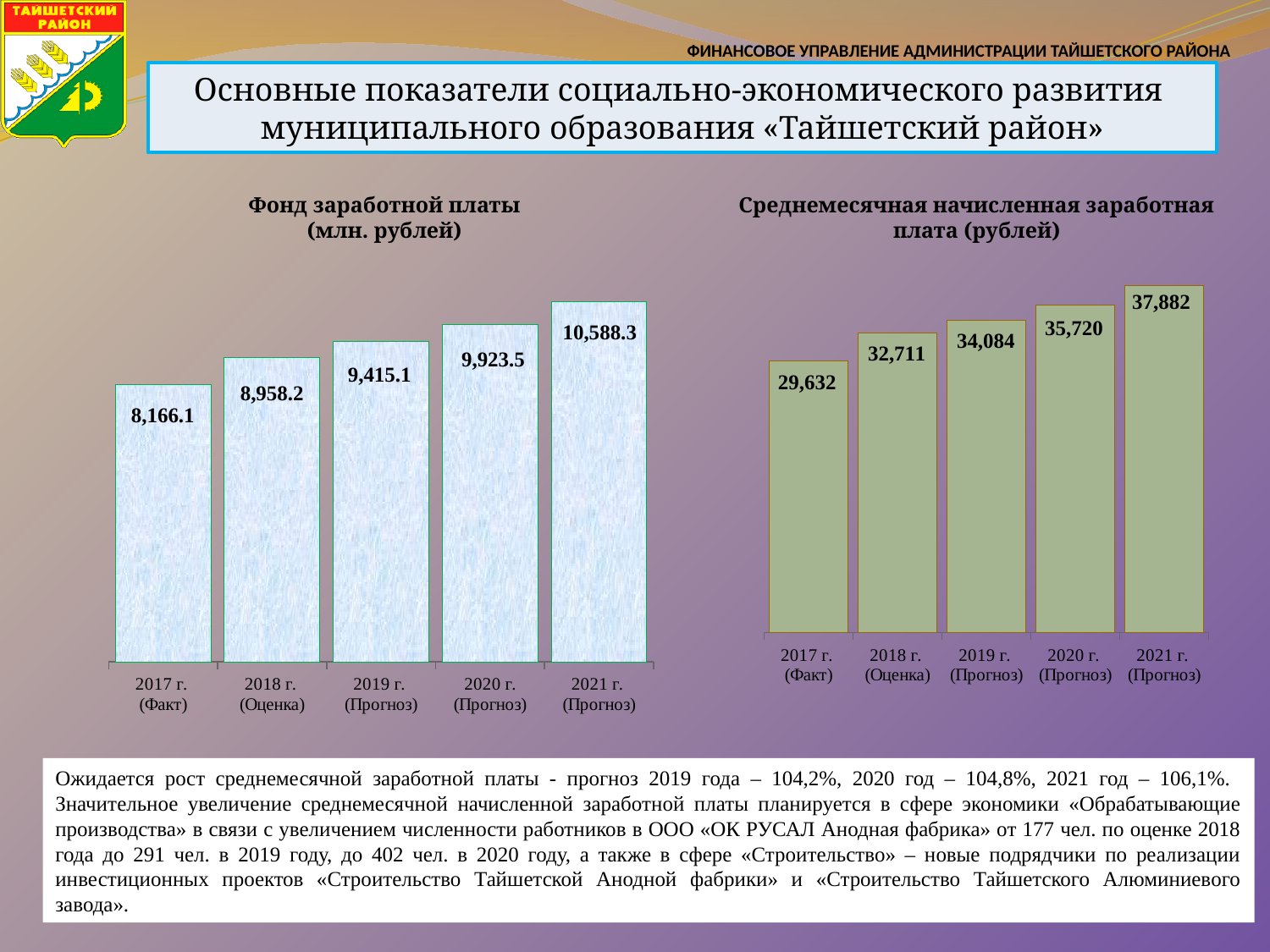
How many bars are in the chart titled «Среднемесячная начисленная заработная плата (рублей)»? 5 In the chart titled «Фонд заработной платы (млн. рублей)», which is larger: the value for 2019 г. or the value for 2018 г.? 2019 г. In the chart titled «Среднемесячная начисленная заработная плата (рублей)», which year has the lowest value? 2017 г. (Факт) In the chart titled «Фонд заработной платы (млн. рублей)», what is the value for 2017 г. (Факт)? 8,166.1 In the chart titled «Фонд заработной платы (млн. рублей)», what is the value for 2020 г. (Прогноз)? 9,923.5 In the chart titled «Среднемесячная начисленная заработная плата (рублей)», what is the value for 2021 г. (Прогноз)? 37,882 In the chart titled «Фонд заработной платы (млн. рублей)», which year has the highest value? 2021 г. (Прогноз) In the chart titled «Фонд заработной платы (млн. рублей)», what is the difference between the 2021 г. value and the 2017 г. value? 2,422.2 In the chart titled «Среднемесячная начисленная заработная плата (рублей)», what is the value for 2019 г. (Прогноз)? 34,084 In the chart titled «Среднемесячная начисленная заработная плата (рублей)», do the values rise or fall from 2017 г. to 2021 г.? Rise In the chart titled «Среднемесячная начисленная заработная плата (рублей)», what is the difference between the 2018 г. value and the 2017 г. value? 3,079 What type of chart is the chart titled «Фонд заработной платы (млн. рублей)»? Bar chart